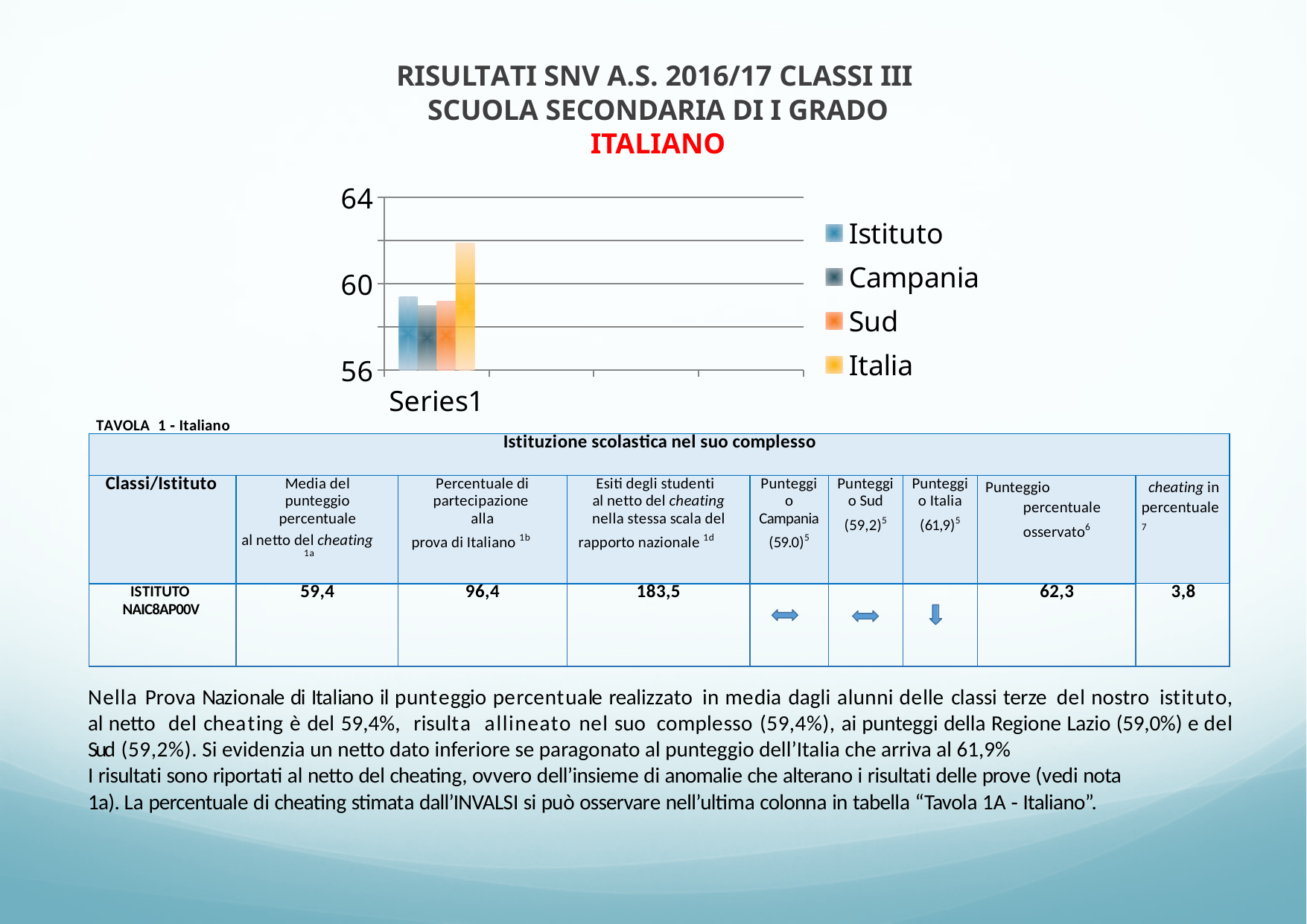
What kind of chart is shown on the slide? bar chart How many categories are shown on the x axis of the chart? 1 Which series has the highest bar in the chart? Italia Is the value for Italia greater or less than 60? greater What is the label of the single category on the x axis of the chart? Series1 How many series does the chart legend list? 4 Is the value for Istituto greater or less than 60? less Is the value for Sud greater or less than 60? less Which is larger in the chart, the value for Italia or the value for Istituto? Italia What is the highest value shown on the chart's y axis? 64